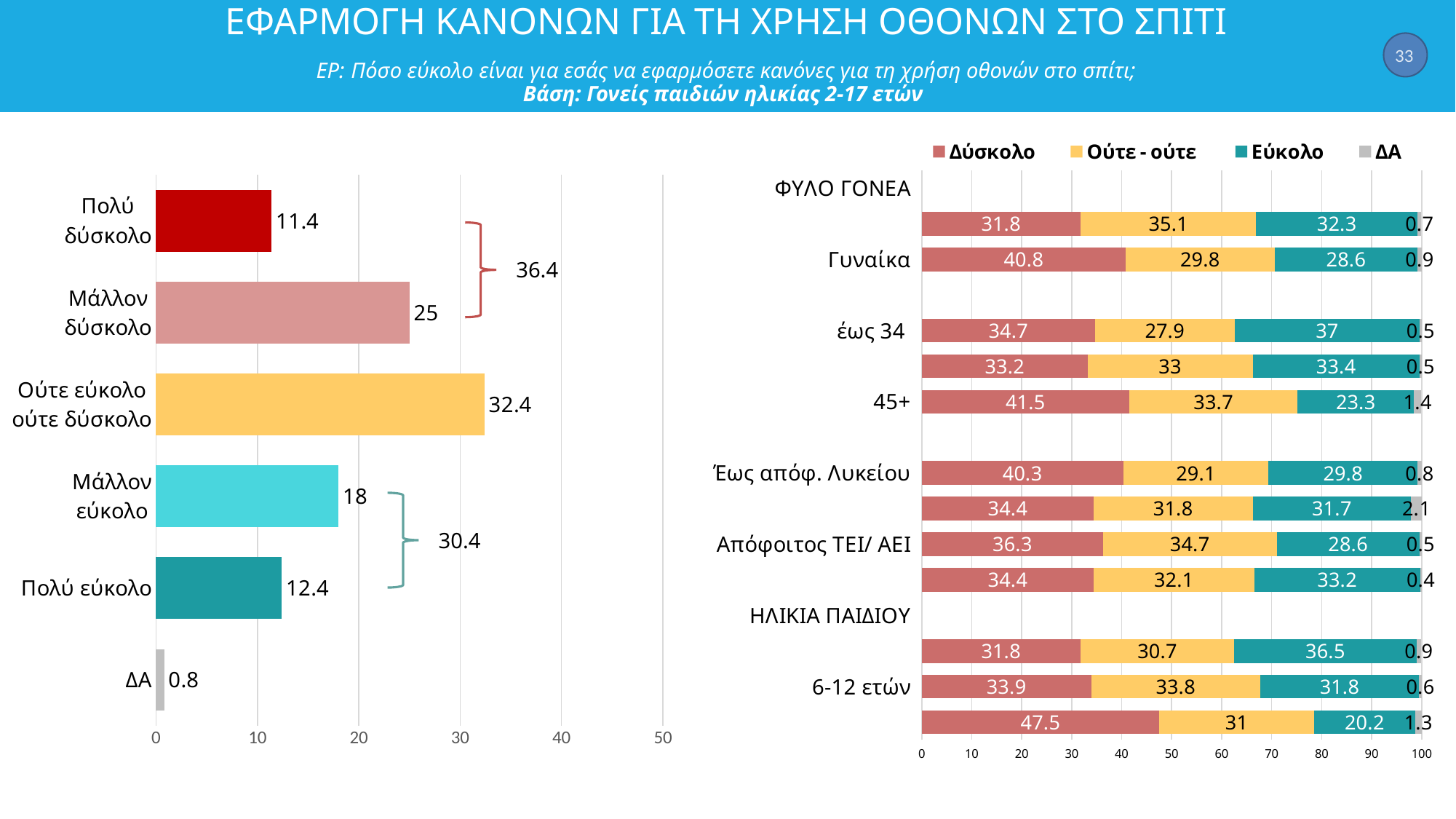
In the left bar chart, which category has the lowest value? ΔΑ How many categories does the left bar chart show? 6 In the right-hand stacked bar chart, which has the larger Εύκολο value: έως 34 or 45+? έως 34 In the left bar chart, which category has the highest value? Ούτε εύκολο ούτε δύσκολο In the left bar chart, which is larger: Πολύ εύκολο or Πολύ δύσκολο? Πολύ εύκολο What kind of chart is the chart on the left of the slide? bar chart In the right-hand stacked bar chart, what is the Εύκολο value for 45+? 23.3 In the right-hand stacked bar chart, what is the difference between the Δύσκολο values for Έως απόφ. Λυκείου and Απόφοιτος ΤΕΙ/ ΑΕΙ? 4 In the right-hand stacked bar chart, what is the Δύσκολο value for Γυναίκα? 40.8 In the left bar chart, what is the value for Ούτε εύκολο ούτε δύσκολο? 32.4 In the left bar chart, what is the difference between the values for Μάλλον δύσκολο and Πολύ δύσκολο? 13.6 How many series does the legend of the right-hand stacked bar chart list? 4